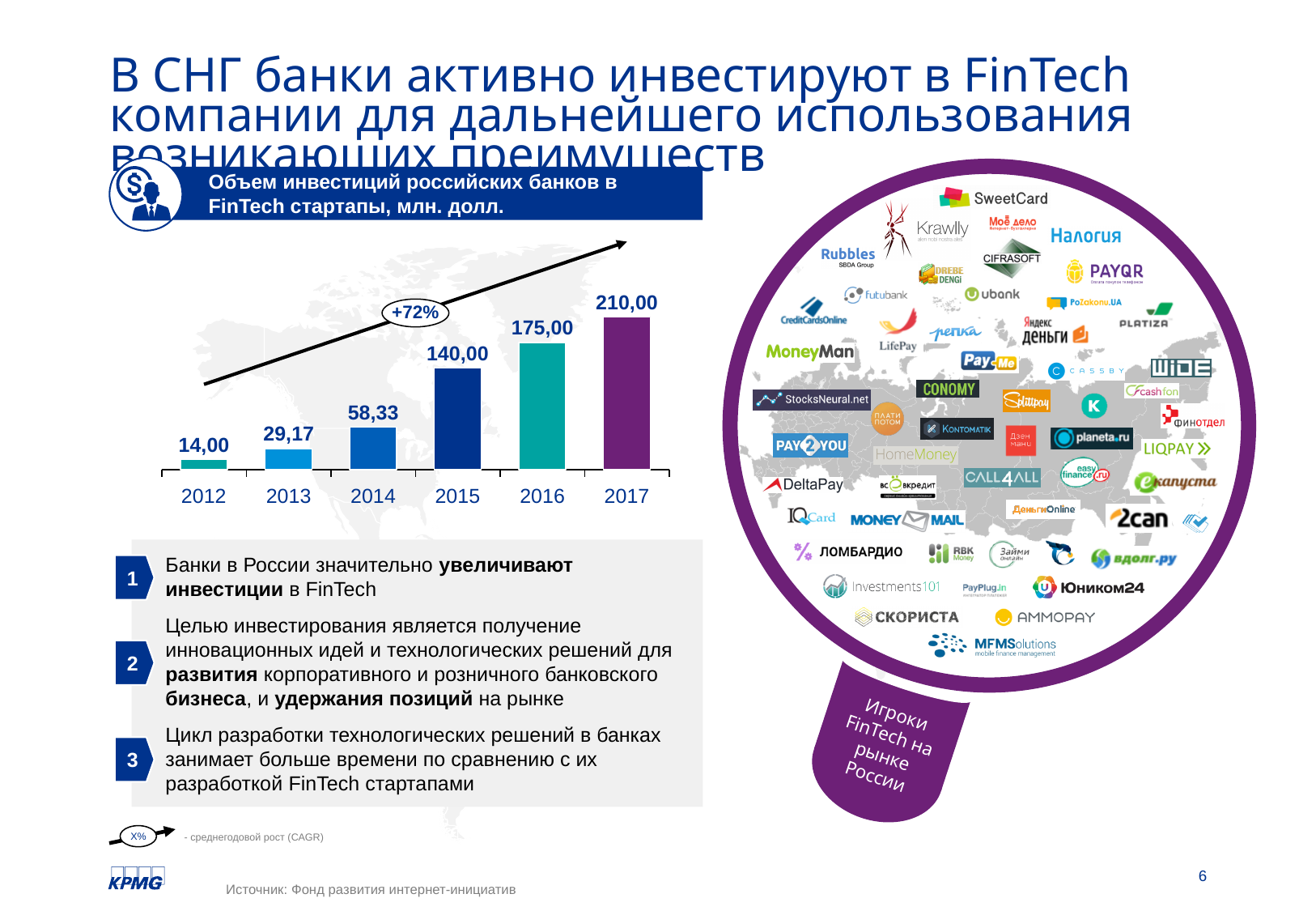
Which year has the lowest value in the chart of Russian banks' investments in FinTech startups? 2012 What is the difference between the 2017 and 2016 values in the chart of Russian banks' investments in FinTech startups? 35,00 What kind of chart shows Russian banks' investments in FinTech startups? Bar chart What is the value for 2014 in the chart of Russian banks' investments in FinTech startups? 58,33 How many years are shown in the chart of Russian banks' investments in FinTech startups? 6 What is the value for 2016 in the chart of Russian banks' investments in FinTech startups? 175,00 What average annual growth rate (CAGR) is shown on the chart of Russian banks' investments in FinTech startups? +72% What is the value for 2012 in the chart of Russian banks' investments in FinTech startups? 14,00 Do the values in the chart of Russian banks' investments in FinTech startups rise or fall from 2012 to 2017? Rise Which year has the highest value in the chart of Russian banks' investments in FinTech startups? 2017 What is the difference between the 2015 and 2014 values in the chart of Russian banks' investments in FinTech startups? 81,67 Which is larger in the chart of Russian banks' investments in FinTech startups: the value for 2013 or the value for 2014? 2014